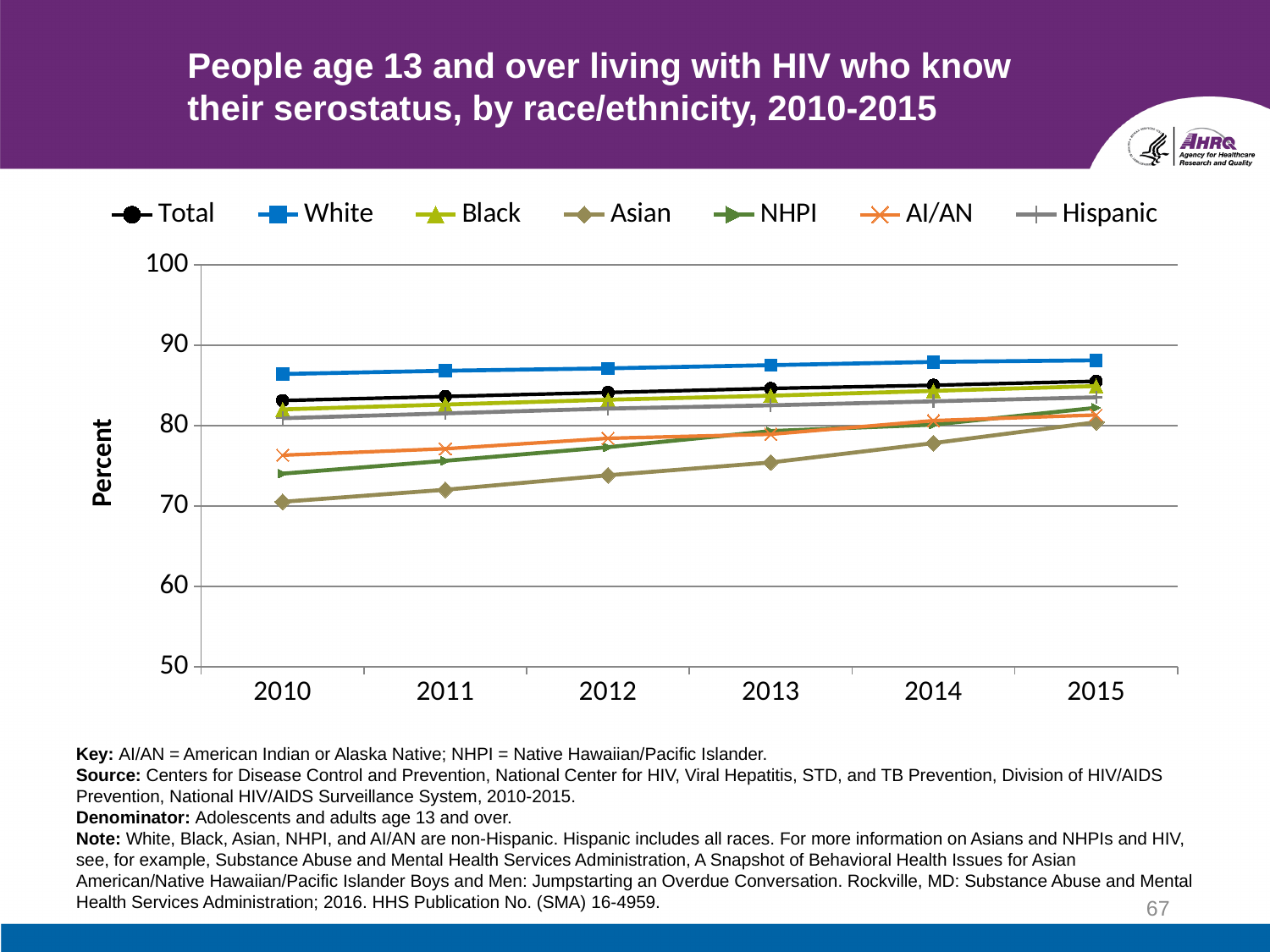
What is the label on the y axis? Percent Which series in the legend is drawn with an X marker? AI/AN How many years are plotted along the x axis? 6 Is the value for Asian in 2010 greater or less than 80? less In 2013, which is larger: the value for White or the value for Asian? White How many series does the legend list? 7 Which race/ethnicity group has the lowest value in 2010? Asian Is the value for White in 2015 greater or less than 80? greater Does the value for Asian rise or fall from 2010 to 2015? rise Which race/ethnicity group has the highest value in 2010? White Is the value for NHPI in 2010 greater or less than 80? less What kind of chart is shown on the slide? line chart